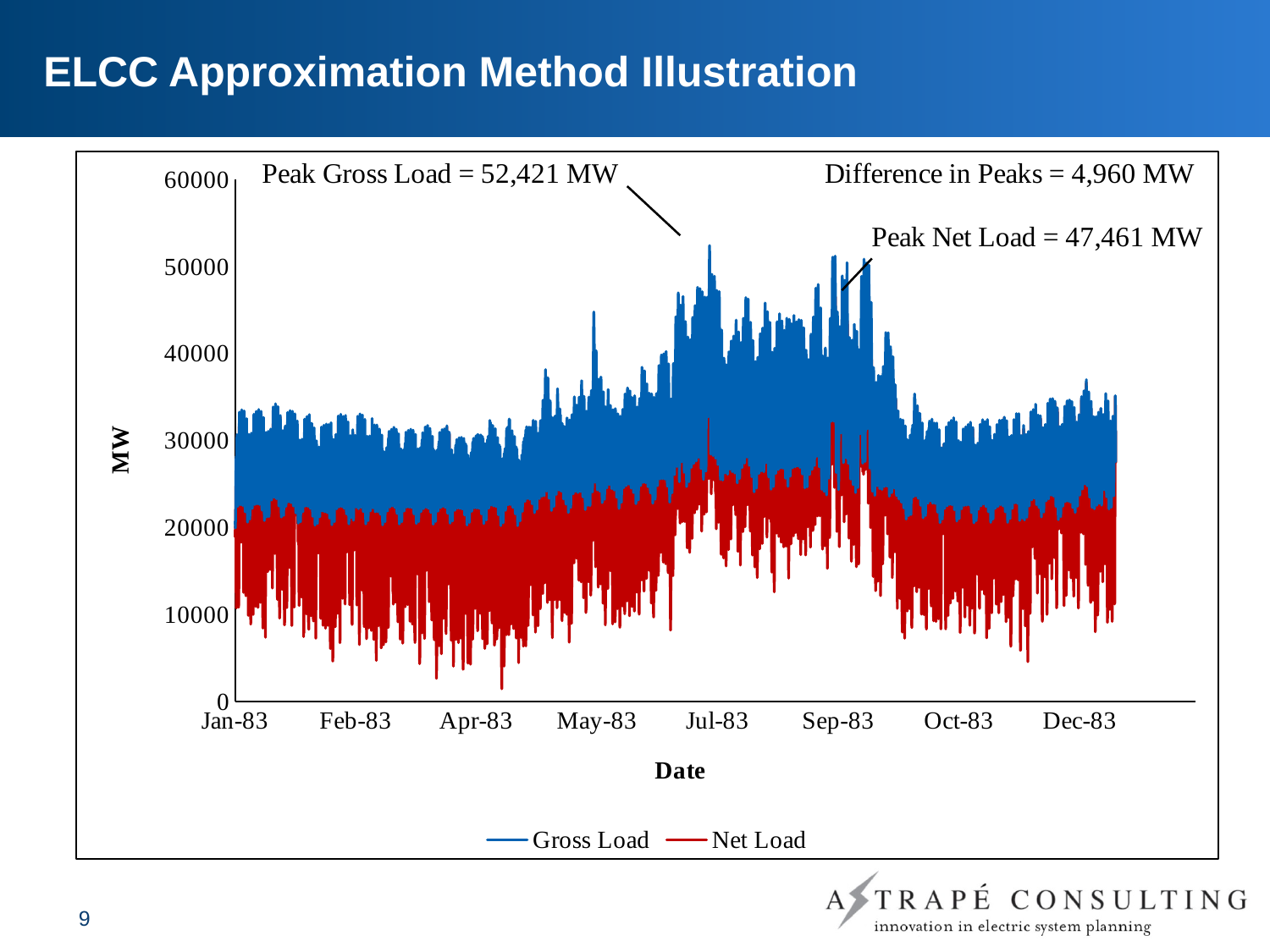
Is the peak gross load greater or less than 50000 MW? greater Is the gross load in Jan-83 greater or less than 40000 MW? less What is the peak net load shown on the chart? 47,461 MW How many series does the legend list? 2 Which colour represents Net Load in the chart? Red What is the label of the y axis? MW What is the peak gross load shown on the chart? 52,421 MW What kind of chart is shown on the slide? Line chart Is the peak net load greater or less than 50000 MW? less Which series has the higher peak, Gross Load or Net Load? Gross Load Does the gross load generally rise or fall from Apr-83 to Jul-83? rise What is the difference between the peak gross load and the peak net load? 4,960 MW